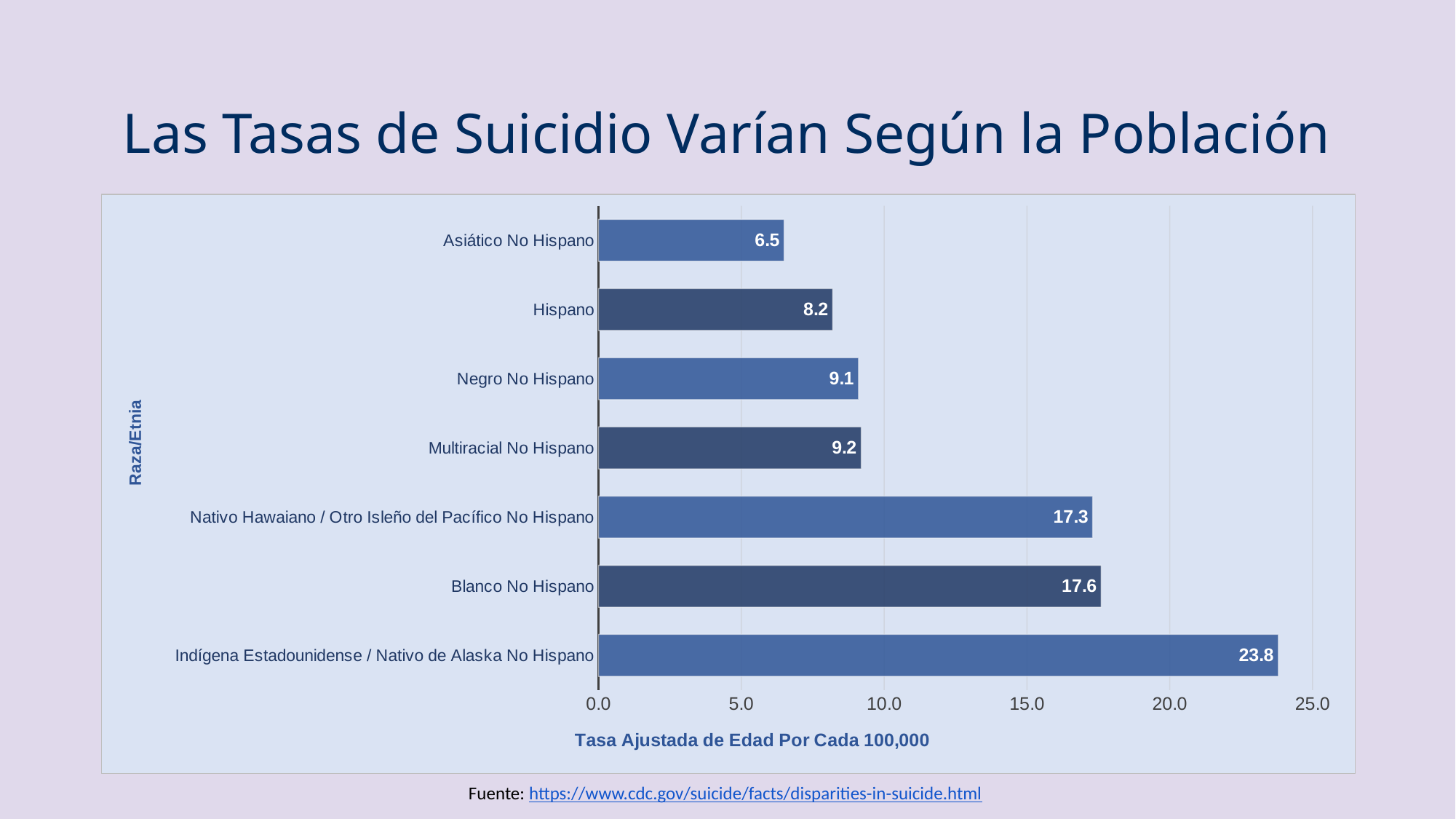
What kind of chart is shown on the slide? Bar chart What is the value shown for Blanco No Hispano? 17.6 Which race/ethnicity group has the highest suicide rate on the chart? Indígena Estadounidense / Nativo de Alaska No Hispano What is the value shown for Nativo Hawaiano / Otro Isleño del Pacífico No Hispano? 17.3 Which race/ethnicity group has the lowest suicide rate on the chart? Asiático No Hispano What is the difference between the rates for Blanco No Hispano and Hispano? 9.4 What is the difference between the rates for Indígena Estadounidense / Nativo de Alaska No Hispano and Asiático No Hispano? 17.3 Is the value for Multiracial No Hispano greater or less than 10.0? less How many race/ethnicity categories are shown on the chart? 7 What is the age-adjusted suicide rate per 100,000 for Hispano? 8.2 Which has a higher rate, Negro No Hispano or Hispano? Negro No Hispano What is the label of the horizontal axis of the chart? Tasa Ajustada de Edad Por Cada 100,000